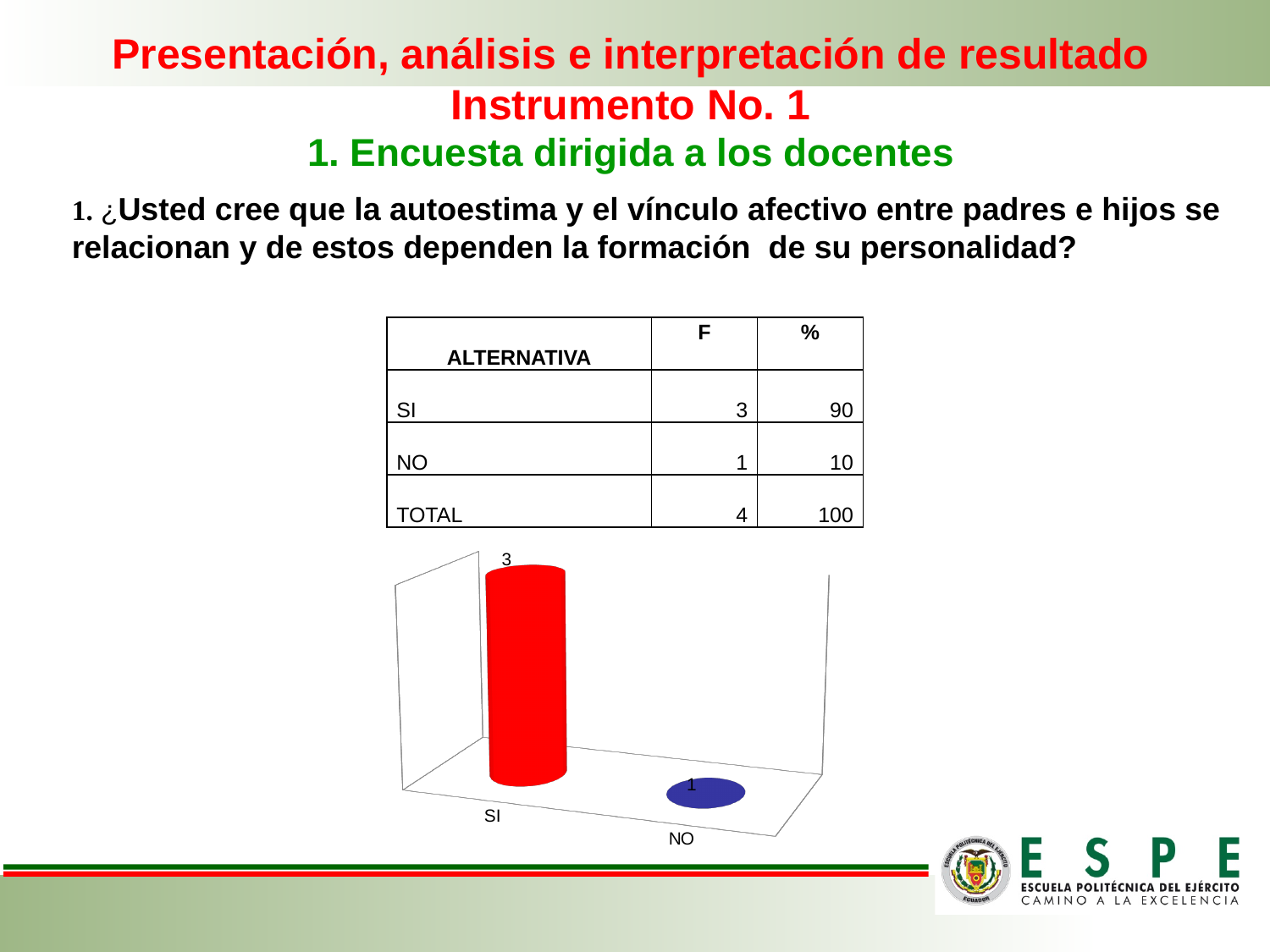
What colour is the bar for NO in the chart? Blue Which category has the highest value in the chart? SI What is the difference between the values for SI and NO in the chart? 2 What is the total of the values plotted in the chart? 4 What is the value shown for NO in the chart? 1 What is the value shown for SI in the chart? 3 Which is larger in the chart, the value for SI or the value for NO? SI How many categories are plotted in the chart? 2 What colour is the bar for SI in the chart? Red What kind of chart is shown on the slide? Bar chart Which category has the lowest value in the chart? NO